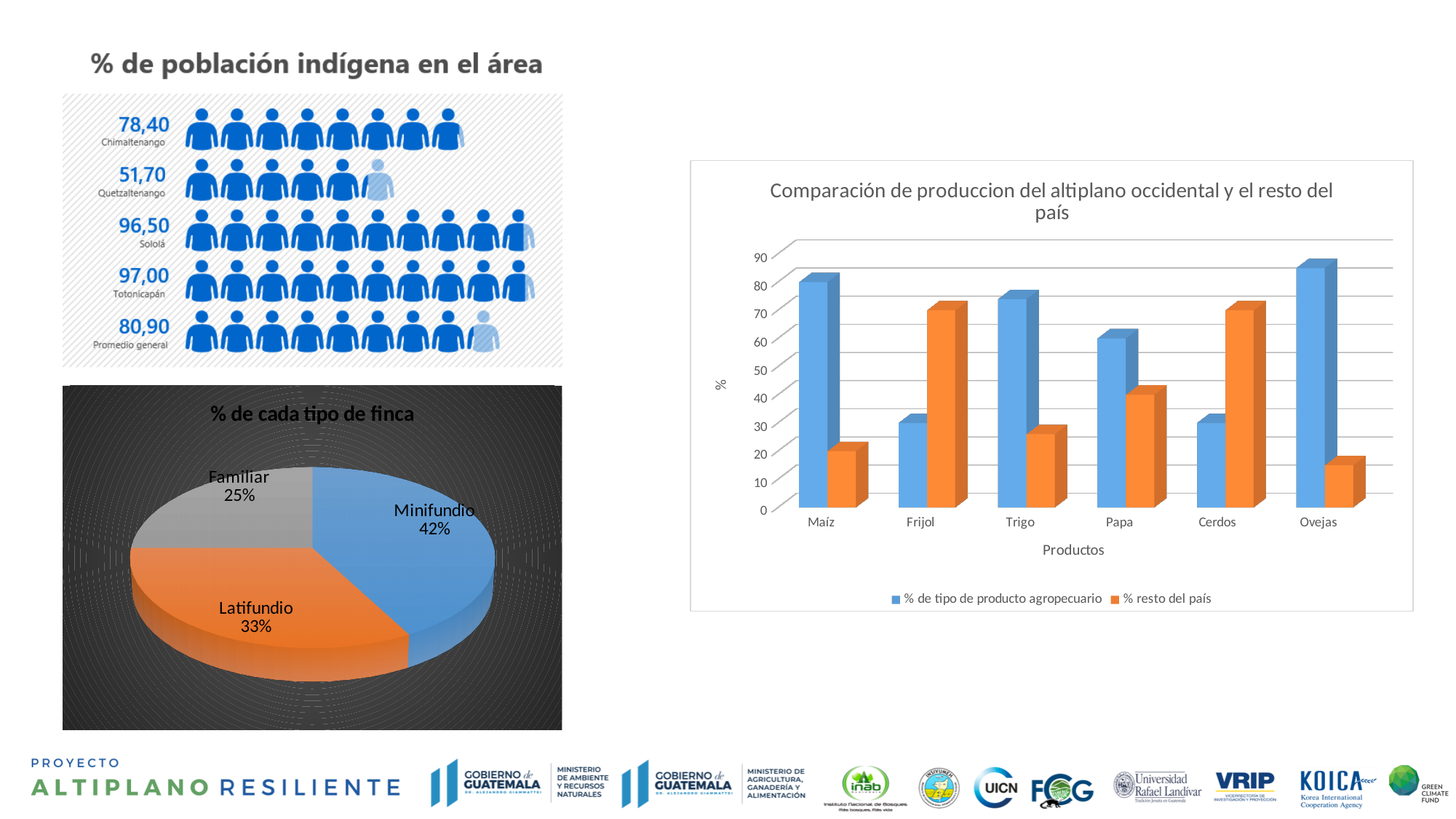
In the chart '% de población indígena en el área', what is the value for Promedio general? 80,90 In the chart 'Comparación de produccion del altiplano occidental y el resto del país', how many series does the legend list? 2 In the chart '% de población indígena en el área', which area has the lowest value? Quetzaltenango In the chart '% de población indígena en el área', what is the value for Sololá? 96,50 In the chart 'Comparación de produccion del altiplano occidental y el resto del país', which series is larger for Frijol: '% de tipo de producto agropecuario' or '% resto del país'? % resto del país In the chart 'Comparación de produccion del altiplano occidental y el resto del país', how many products are shown on the x axis? 6 In the pie chart '% de cada tipo de finca', what share does Latifundio have? 33% In the chart 'Comparación de produccion del altiplano occidental y el resto del país', is the value of '% de tipo de producto agropecuario' for Maíz greater or less than 70? greater In the pie chart '% de cada tipo de finca', which type of farm has the smallest share? Familiar In the pie chart '% de cada tipo de finca', what share does Minifundio have? 42% In the pie chart '% de cada tipo de finca', what is the difference between the Minifundio and Familiar shares? 17% In the chart '% de población indígena en el área', which area has the highest value? Totonicapán